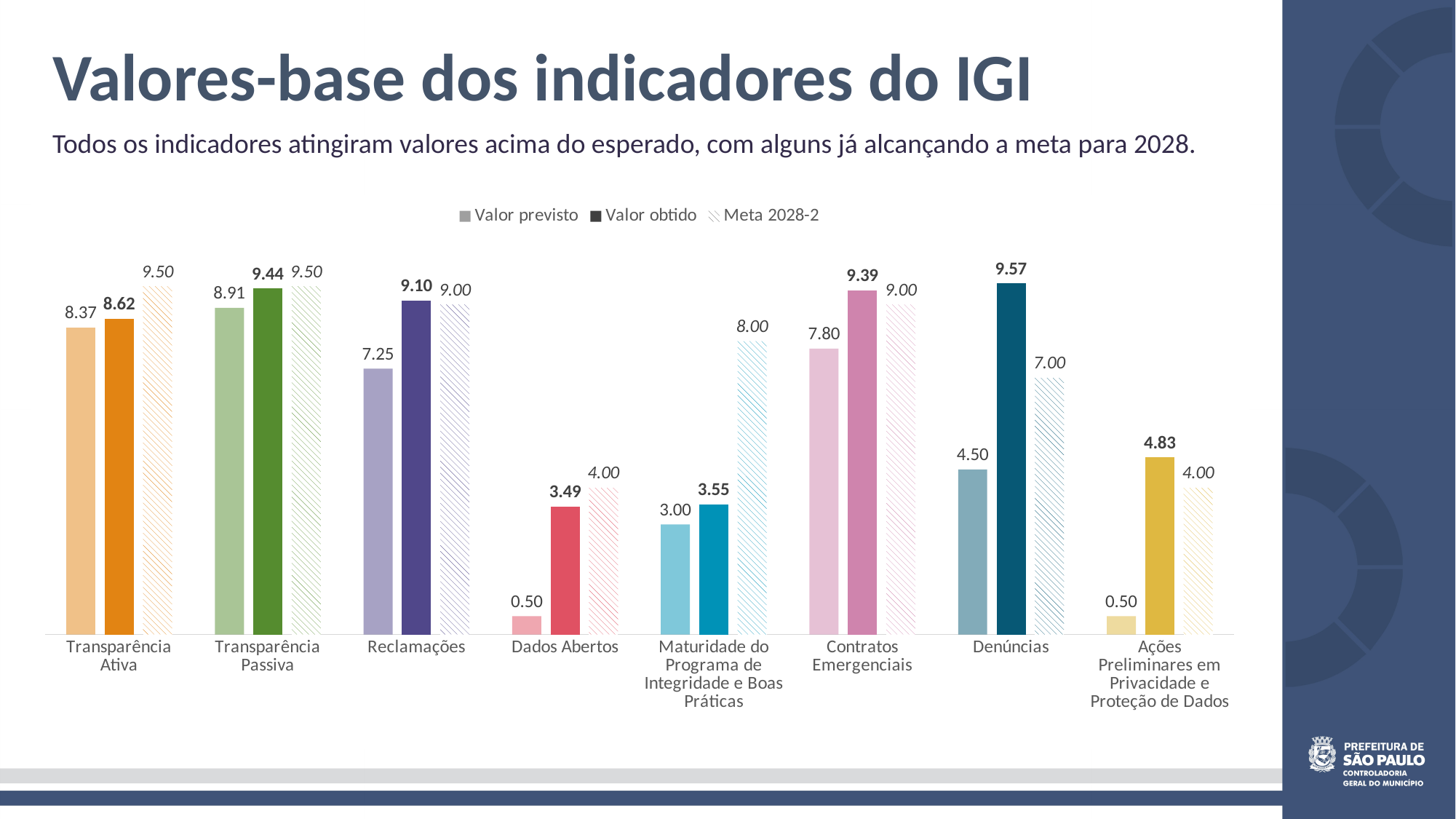
How many series does the legend list? 3 What is the difference between the Valor obtido and the Valor previsto for Denúncias? 5.07 What is the Valor obtido for Denúncias? 9.57 What is the Meta 2028-2 value for Maturidade do Programa de Integridade e Boas Práticas? 8.00 Which category has the lowest Valor obtido? Dados Abertos What is the title of the slide containing the chart? Valores-base dos indicadores do IGI What kind of chart is shown on the slide? Bar chart What is the difference between the Valor obtido and the Valor previsto for Reclamações? 1.85 Which is larger for Contratos Emergenciais: the Valor obtido or the Meta 2028-2? Valor obtido What is the Valor previsto for Reclamações? 7.25 Which category has the highest Valor obtido? Denúncias How many categories are shown on the x axis? 8